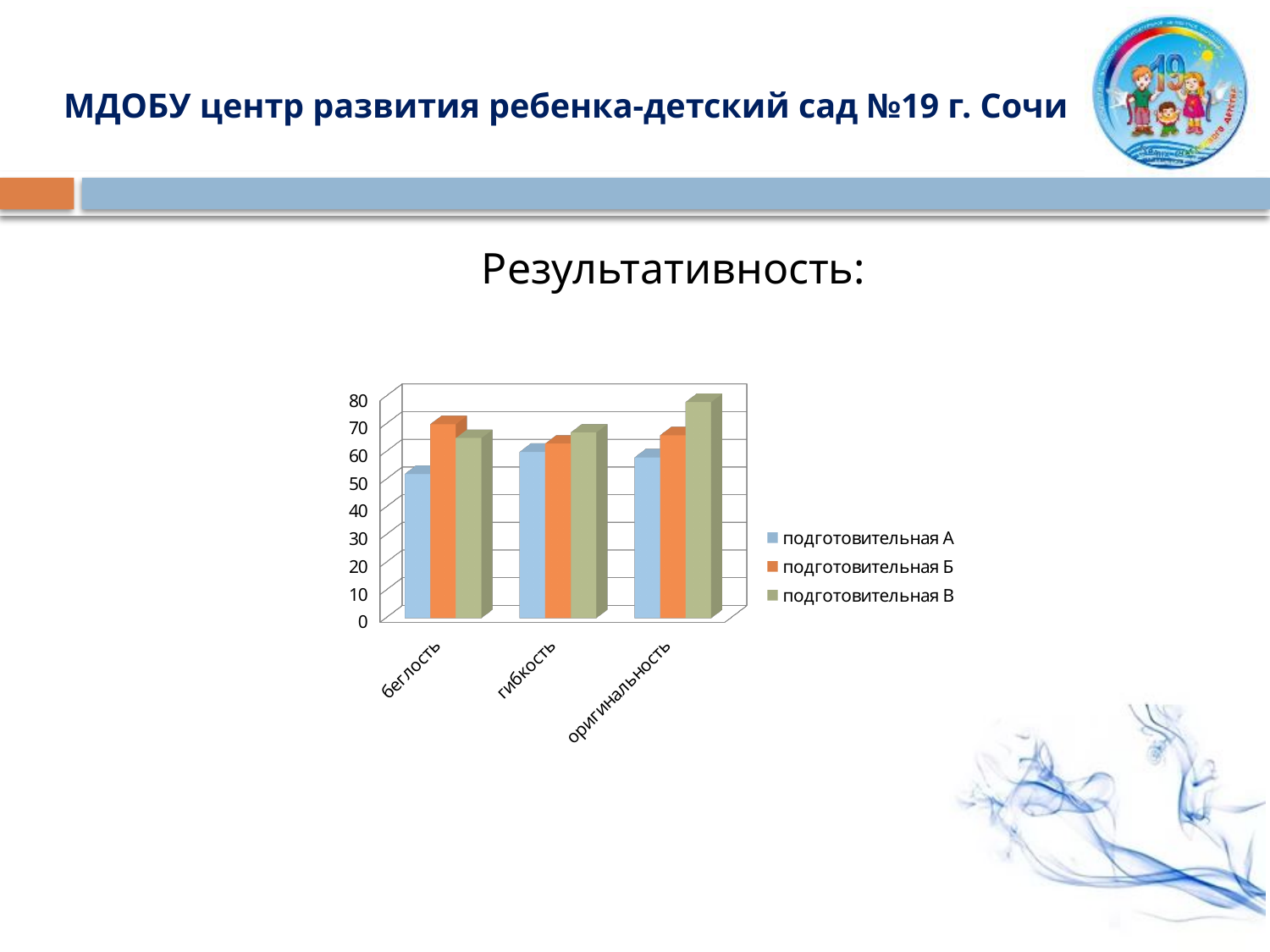
Which series has the highest value for беглость? подготовительная Б How many series does the chart's legend list? 3 Is the value of подготовительная В for оригинальность greater or less than 70? greater Is the value of подготовительная А for беглость greater or less than 60? less What is the title shown above the chart? Результативность: Which series is shown in orange in the chart's legend? подготовительная Б What kind of chart is shown on the slide? bar chart How many categories are shown on the x axis of the chart? 3 Which series has the highest value for оригинальность? подготовительная В Which series has the lowest value for беглость? подготовительная А Is the value of подготовительная Б for беглость greater or less than 60? greater Which is larger: подготовительная В for оригинальность or подготовительная Б for беглость? подготовительная В for оригинальность